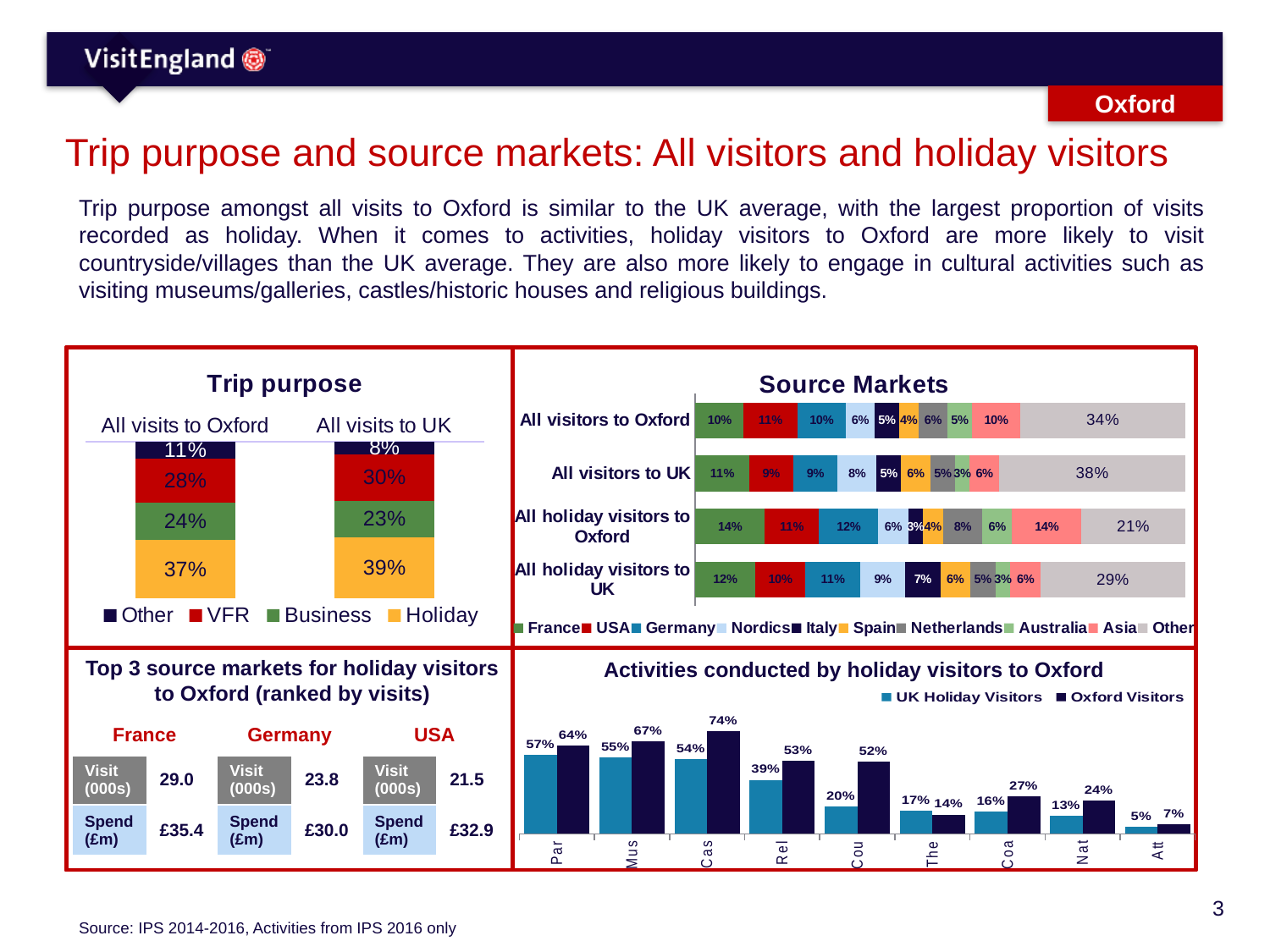
In the Source Markets chart, is the Asia share larger for all holiday visitors to Oxford or for all holiday visitors to UK? All holiday visitors to Oxford In the Trip purpose chart, what percentage of all visits to Oxford are Holiday? 37% How many source markets does the legend of the Source Markets chart list? 10 In the Activities conducted by holiday visitors to Oxford chart, what is the difference between Oxford Visitors and UK Holiday Visitors for Cou? 32% In the Source Markets chart, what percentage of all holiday visitors to Oxford come from France? 14% What kind of chart is the Activities conducted by holiday visitors to Oxford chart? Bar chart In the Trip purpose chart, which trip purpose has the largest share of all visits to Oxford? Holiday How many series does the legend of the Trip purpose chart list? 4 In the Trip purpose chart, what percentage of all visits to UK are VFR? 30% In the Source Markets chart, what is the Other share for all visitors to UK? 38% In the Activities conducted by holiday visitors to Oxford chart, what is the Oxford Visitors value for Cas? 74% In the Trip purpose chart, what is the difference between the Business share for all visits to Oxford and for all visits to UK? 1%